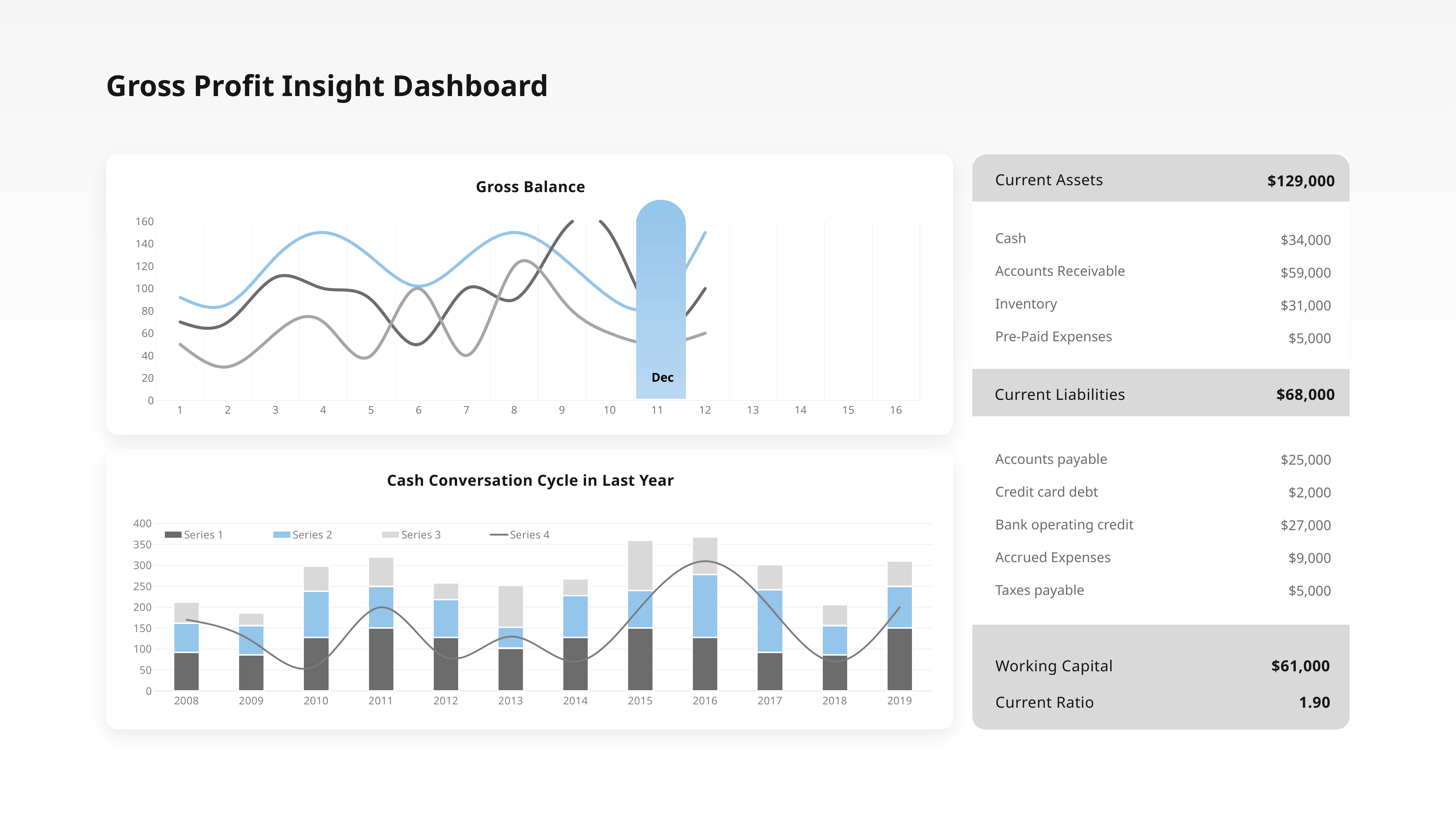
How many years are shown on the x axis of the Cash Conversation Cycle in Last Year chart? 12 On the Cash Conversation Cycle in Last Year chart, is the stacked bar total for 2016 greater or less than 350? greater On the Cash Conversation Cycle in Last Year chart, is the stacked bar total for 2009 greater or less than 200? less On the Cash Conversation Cycle in Last Year chart, which year has the lowest stacked bar total? 2009 What kind of chart is the Gross Balance chart? line chart What kind of chart is the Cash Conversation Cycle in Last Year chart? stacked bar chart with a line How many points are marked on the x axis of the Gross Balance chart? 16 On the Cash Conversation Cycle in Last Year chart, which series is shown in blue? Series 2 On the Cash Conversation Cycle in Last Year chart, which has the larger stacked bar total, 2011 or 2012? 2011 On the Gross Balance chart, which x-axis position is highlighted with a shaded bar labelled Dec? 11 How many series does the legend of the Cash Conversation Cycle in Last Year chart list? 4 On the Cash Conversation Cycle in Last Year chart, is the Series 1 value for 2011 greater or less than 100? greater